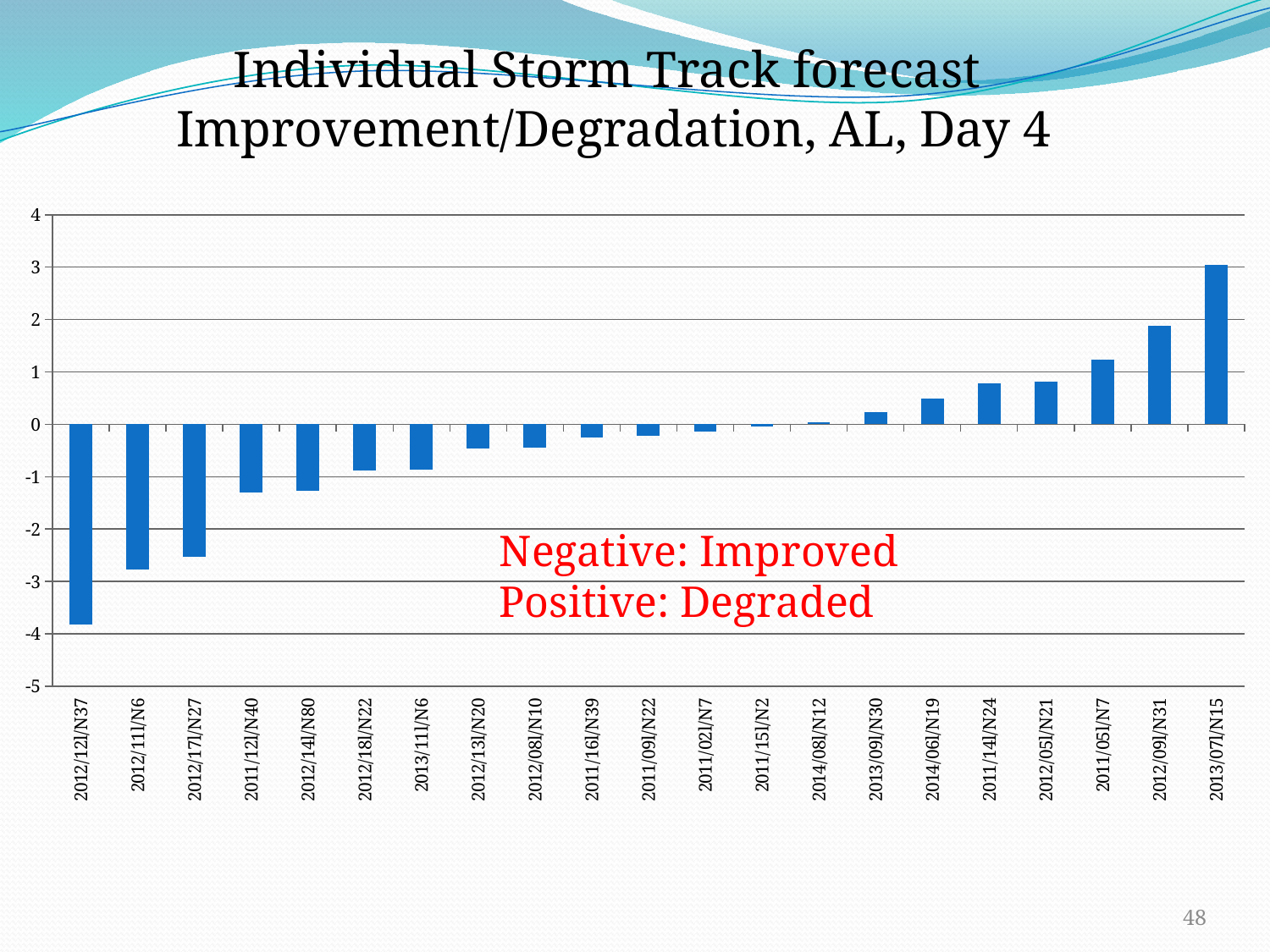
Which storm has the highest (most positive) value? 2013/07l/N15 What kind of chart is shown on the slide? bar chart Is the value for 2012/17l/N27 greater or less than -2? less Is the value for 2012/12l/N37 greater or less than -3? less Which has the larger value, 2012/11l/N6 or 2012/18l/N22? 2012/18l/N22 Which storm has the lowest (most negative) value? 2012/12l/N37 Which has the larger value, 2011/05l/N7 or 2012/05l/N21? 2011/05l/N7 Do the bar values rise or fall moving from left to right along the x axis? rise Is the value for 2012/09l/N31 greater or less than 1? greater How many storm categories are plotted along the x axis? 21 According to the red annotation on the chart, what does a negative value indicate? Improved